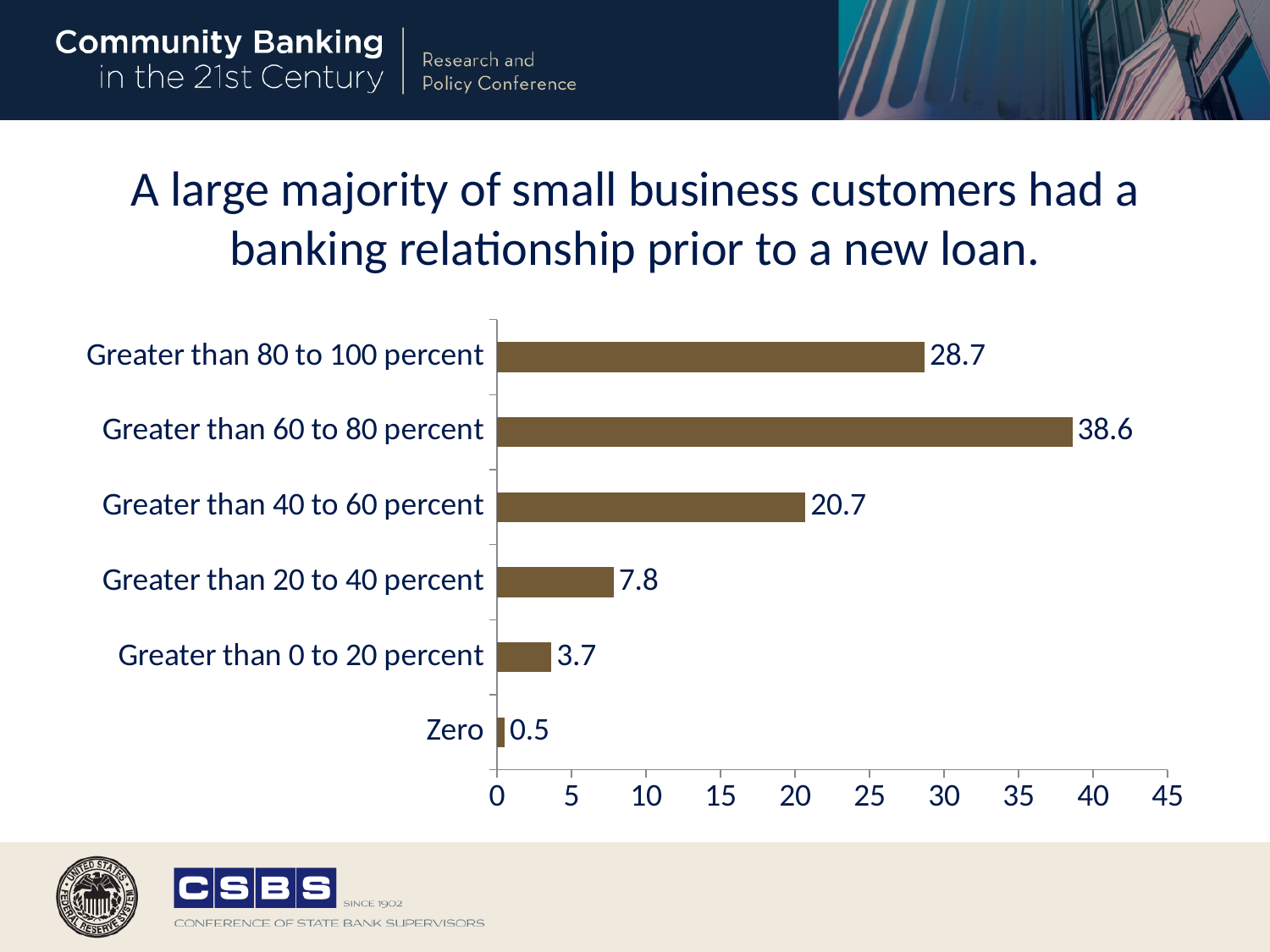
What is the value for the 'Zero' category? 0.5 Which category has the lowest value? Zero How many categories are shown in the chart? 6 What is the value for the 'Greater than 20 to 40 percent' category? 7.8 Which is larger, the value for 'Greater than 40 to 60 percent' or 'Greater than 0 to 20 percent'? Greater than 40 to 60 percent What is the difference between the values for 'Greater than 40 to 60 percent' and 'Greater than 20 to 40 percent'? 12.9 What is the maximum value shown on the horizontal axis? 45 What is the value for the 'Greater than 80 to 100 percent' category? 28.7 Which category has the highest value? Greater than 60 to 80 percent What is the value for the 'Greater than 60 to 80 percent' category? 38.6 What kind of chart is shown on the slide? Bar chart What is the difference between the values for 'Greater than 60 to 80 percent' and 'Greater than 80 to 100 percent'? 9.9